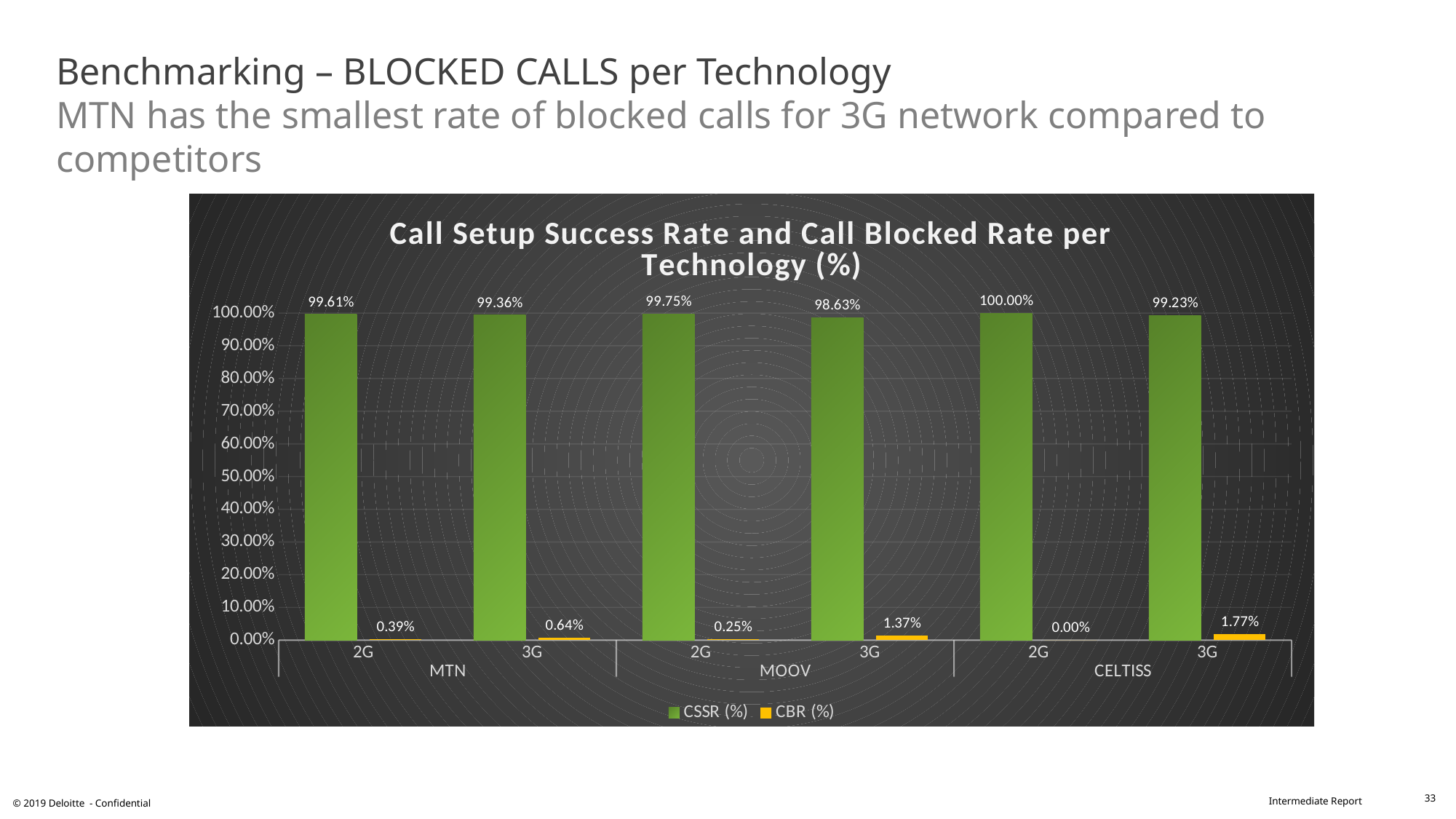
What is the CSSR (%) value for MTN 3G? 99.36% Which operator and technology has the highest CSSR (%)? CELTISS 2G How many series does the legend list? 2 What is the CBR (%) value for MOOV 2G? 0.25% Which operator and technology has the highest CBR (%)? CELTISS 3G How many bars are plotted for the CSSR (%) series? 6 Which operator and technology has the lowest CSSR (%)? MOOV 3G What is the CBR (%) value for CELTISS 3G? 1.77% What colour represents the CBR (%) series in the chart? Orange What is the difference between the CBR (%) for CELTISS 3G and MTN 3G? 1.13% Which is larger, the CBR (%) for MOOV 3G or the CBR (%) for MTN 3G? MOOV 3G What kind of chart is shown on the slide? Bar chart